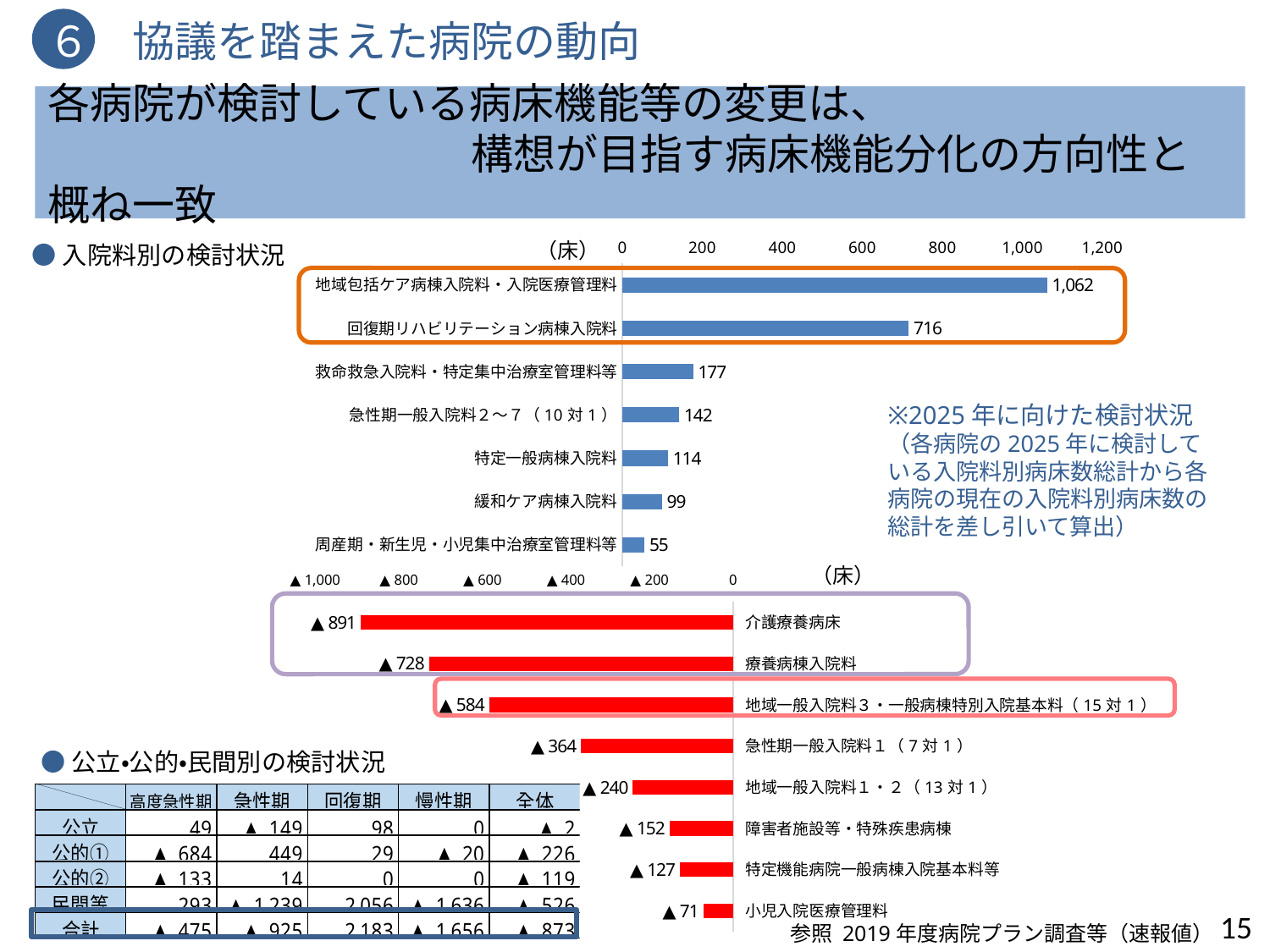
In the upper (blue) bar chart, how many categories are plotted? 7 In the upper (blue) bar chart, what is the value for 回復期リハビリテーション病棟入院料? 716 What type of chart is the upper chart showing 入院料別の検討状況? Bar chart In the lower (red) bar chart, which has the larger decrease, 急性期一般入院料1（7対1） or 地域一般入院料1・2（13対1）? 急性期一般入院料1（7対1） In the lower (red) bar chart, what is the value shown for 介護療養病床? ▲ 891 In the lower (red) bar chart, what is the value shown for 地域一般入院料3・一般病棟特別入院基本料（15対1）? ▲ 584 In the lower (red) bar chart, which category has the largest decrease (longest bar)? 介護療養病床 In the upper (blue) bar chart, what is the difference between 救命救急入院料・特定集中治療室管理料等 and 急性期一般入院料2～7（10対1）? 35 In the upper (blue) bar chart, what is the value for 地域包括ケア病棟入院料・入院医療管理料? 1,062 In the upper (blue) bar chart, which category has the lowest value? 周産期・新生児・小児集中治療室管理料等 In the upper (blue) bar chart, is the value for 特定一般病棟入院料 greater or less than 200? less In the lower (red) bar chart, how many categories are plotted? 8